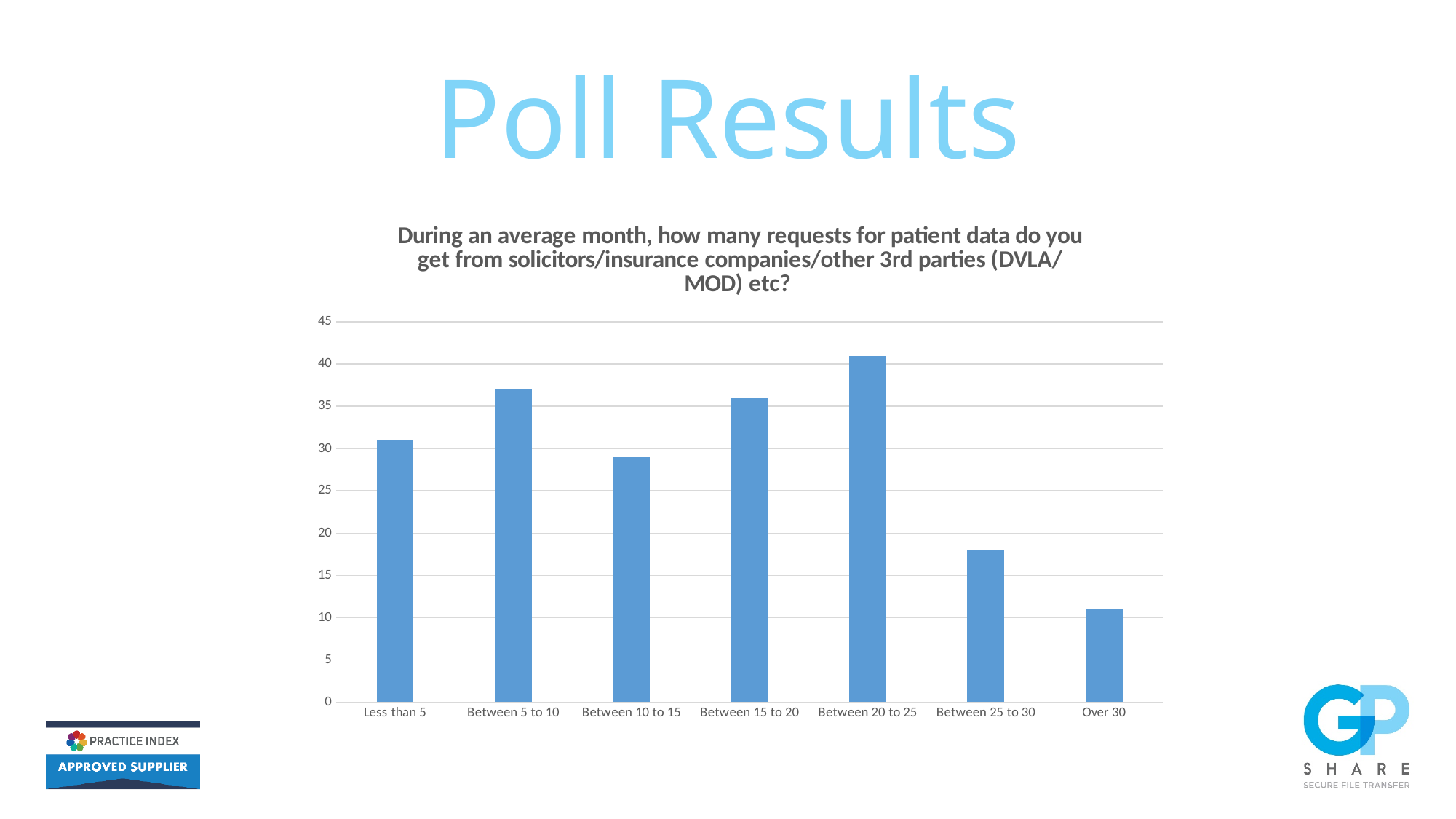
Which is larger, the value for Between 5 to 10 or the value for Between 25 to 30? Between 5 to 10 Which category has the lowest bar in the chart? Over 30 What is the highest value shown on the chart's vertical axis? 45 Is the value for Less than 5 greater or less than 30? greater Is the value for Over 30 greater or less than 15? less Is the value for Between 10 to 15 greater or less than 30? less What kind of chart is shown on the slide? bar chart How many categories are shown on the x axis of the chart? 7 Which category has the highest bar in the chart? Between 20 to 25 Which is larger, the value for Between 15 to 20 or the value for Over 30? Between 15 to 20